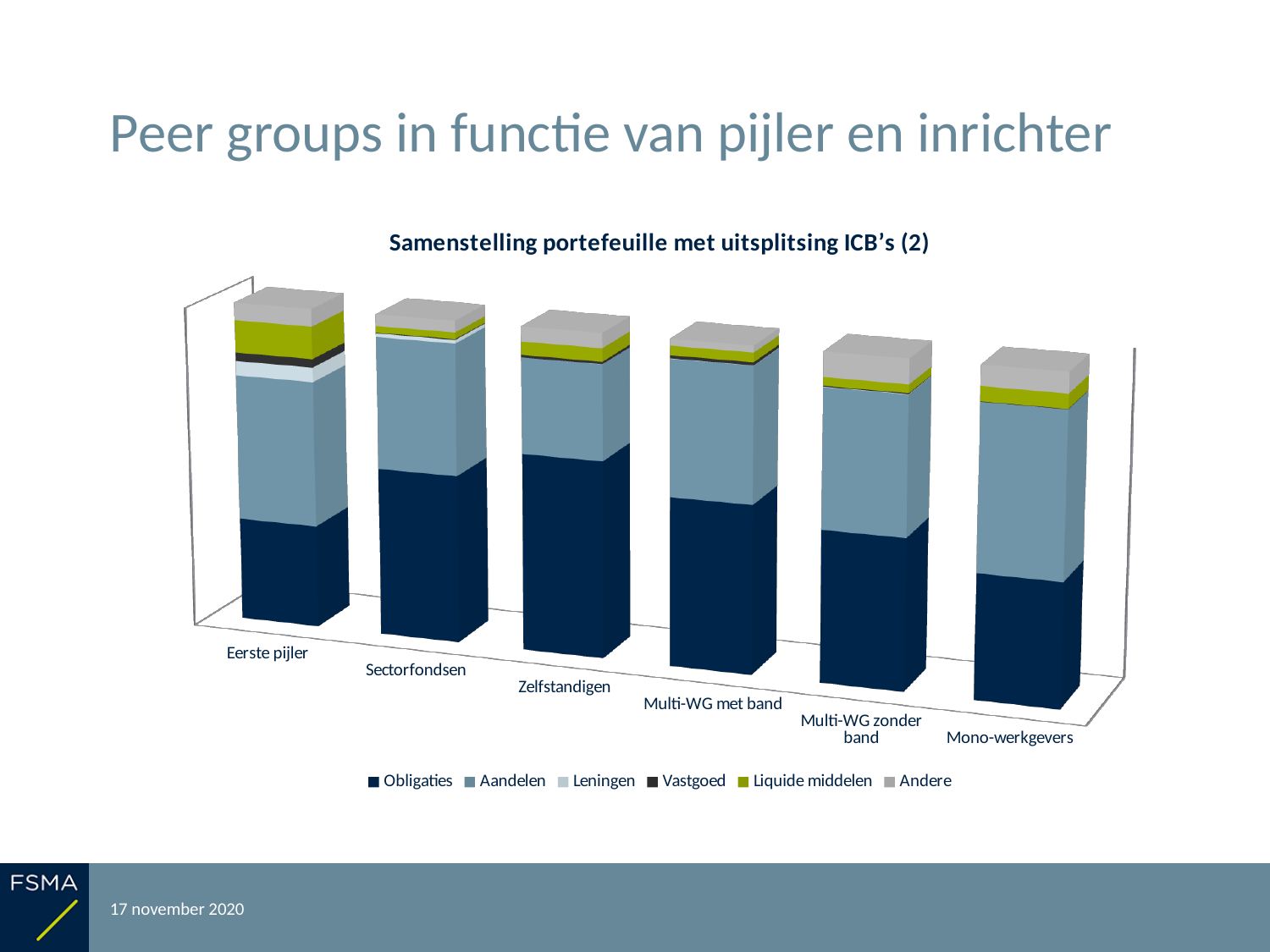
What is the title of the chart? Samenstelling portefeuille met uitsplitsing ICB's (2) Is the Liquide middelen segment larger for Eerste pijler or for Sectorfondsen? Eerste pijler How many series does the chart legend list? 6 Which category is shown last (rightmost) on the x axis? Mono-werkgevers How many categories (peer groups) are shown on the x axis of the chart? 6 Which series is shown at the bottom of each stacked bar? Obligaties What kind of chart is shown on the slide? Stacked bar chart Is the Obligaties segment larger for Zelfstandigen or for Eerste pijler? Zelfstandigen Which category has the smallest Obligaties segment? Eerste pijler Which category has the largest Liquide middelen segment? Eerste pijler